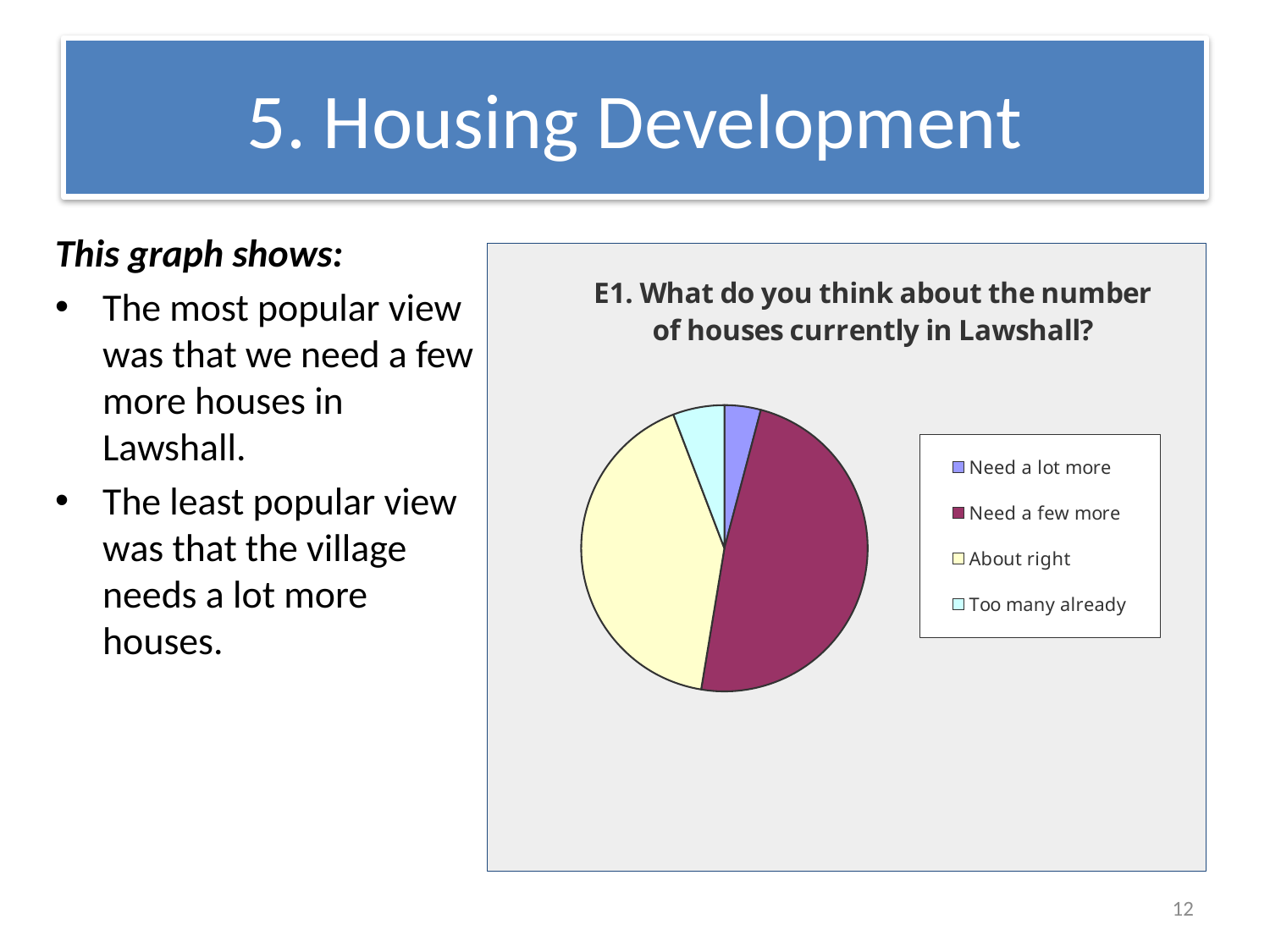
How many entries does the chart legend list? 4 How many categories (slices) does the pie chart have? 4 Which slice is larger: 'Too many already' or 'Need a lot more'? Too many already Which category has the largest slice of the pie? Need a few more What kind of chart is shown on the slide? pie chart Which slice is larger: 'Need a few more' or 'About right'? Need a few more What is the title of the chart? E1. What do you think about the number of houses currently in Lawshall? Which legend entry is shown in yellow? About right Which slice is larger: 'About right' or 'Too many already'? About right Which category has the smallest slice of the pie? Need a lot more